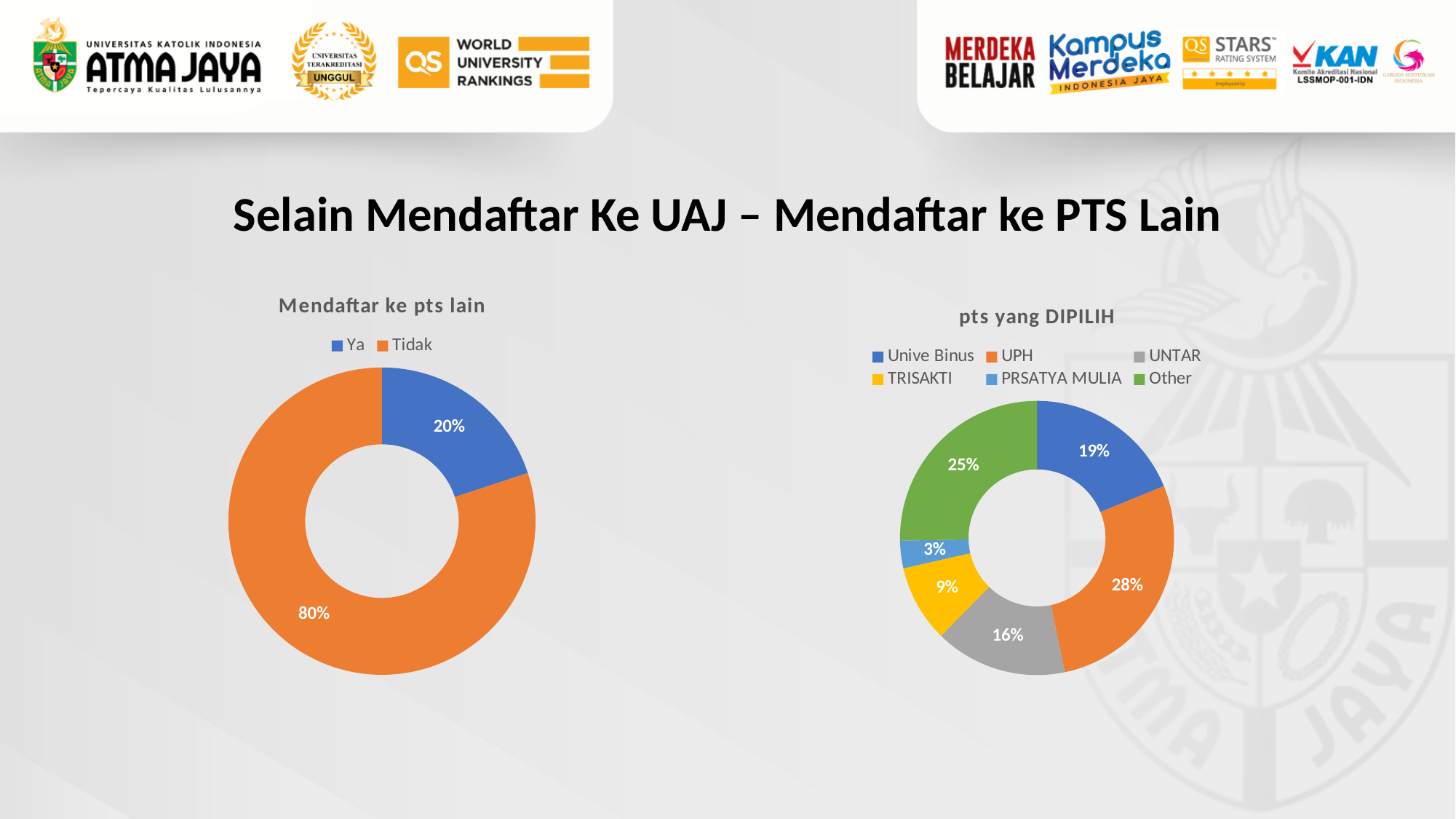
In the 'pts yang DIPILIH' chart, how many categories does the legend list? 6 What kind of chart is the 'pts yang DIPILIH' chart? Doughnut (pie) chart In the 'pts yang DIPILIH' chart, which is larger: UNTAR or TRISAKTI? UNTAR In the 'Mendaftar ke pts lain' chart, what is the difference between the Tidak and Ya shares? 60% In the 'Mendaftar ke pts lain' chart, what percentage is shown for Ya? 20% In the 'pts yang DIPILIH' chart, which category has the largest share? UPH In the 'Mendaftar ke pts lain' chart, how many series does the legend list? 2 In the 'pts yang DIPILIH' chart, what percentage is shown for PRSATYA MULIA? 3% In the 'pts yang DIPILIH' chart, which category has the smallest share? PRSATYA MULIA In the 'pts yang DIPILIH' chart, what is the difference between the Other and Unive Binus shares? 6% In the 'pts yang DIPILIH' chart, what percentage is shown for UPH? 28% In the 'Mendaftar ke pts lain' chart, what percentage is shown for Tidak? 80%